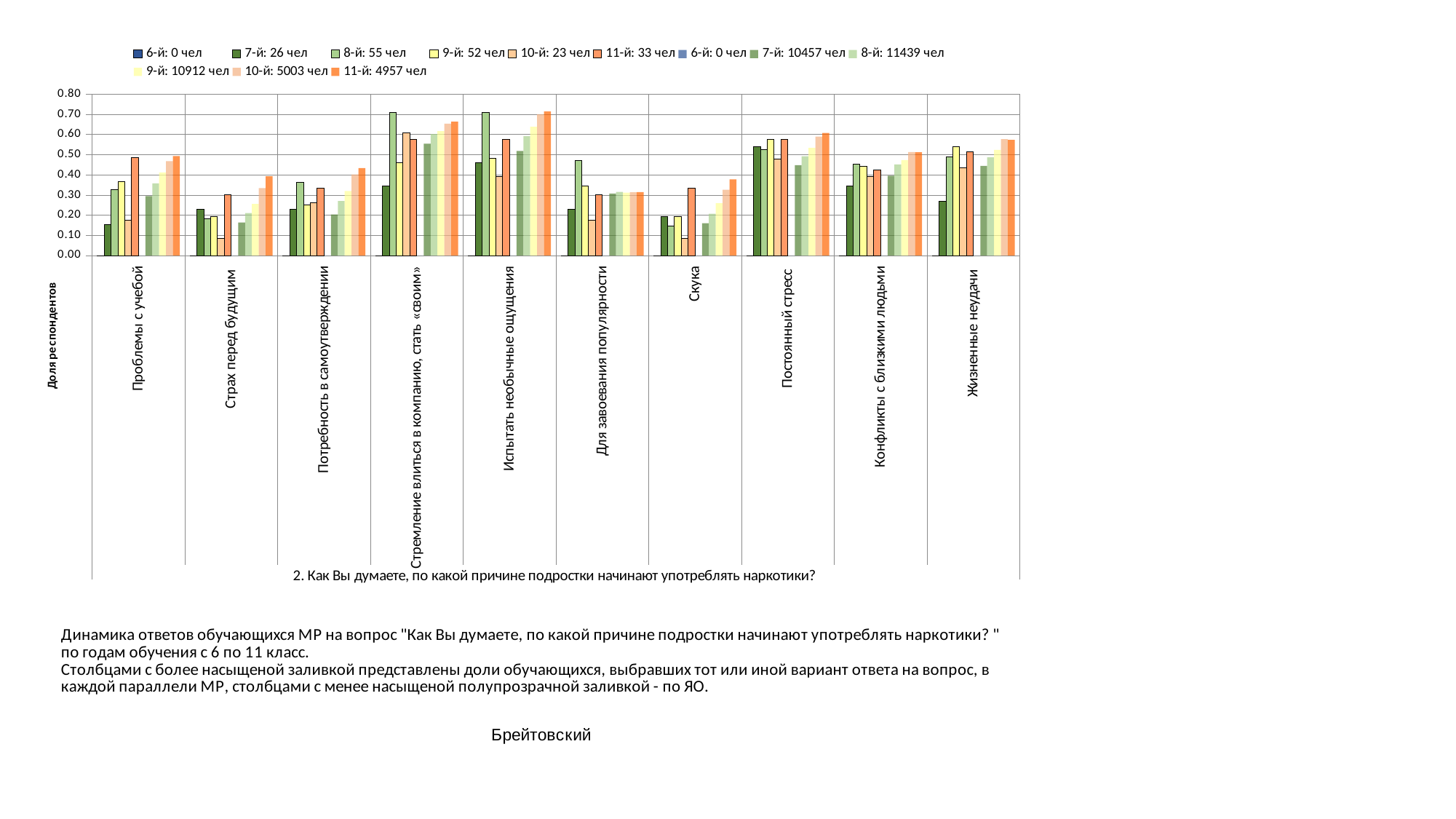
Is the value for the series "8-й: 55 чел" in the category "Для завоевания популярности" greater or less than 0.40? greater What is the title of the vertical axis of the chart? Доля респондентов What text appears as the horizontal axis title below the categories? 2. Как Вы думаете, по какой причине подростки начинают употреблять наркотики? Is the value for the series "7-й: 26 чел" in the category "Скука" greater or less than 0.30? less Is the value for the series "7-й: 26 чел" in the category "Проблемы с учебой" greater or less than 0.20? less What kind of chart is shown on the slide? bar chart In the category "Проблемы с учебой", which is larger: the value for "7-й: 26 чел" or the value for "11-й: 33 чел"? 11-й: 33 чел In the category "Скука", which is larger: the value for "8-й: 55 чел" or the value for "11-й: 33 чел"? 11-й: 33 чел How many categories are shown along the x axis of the chart? 10 How many series does the chart's legend list? 12